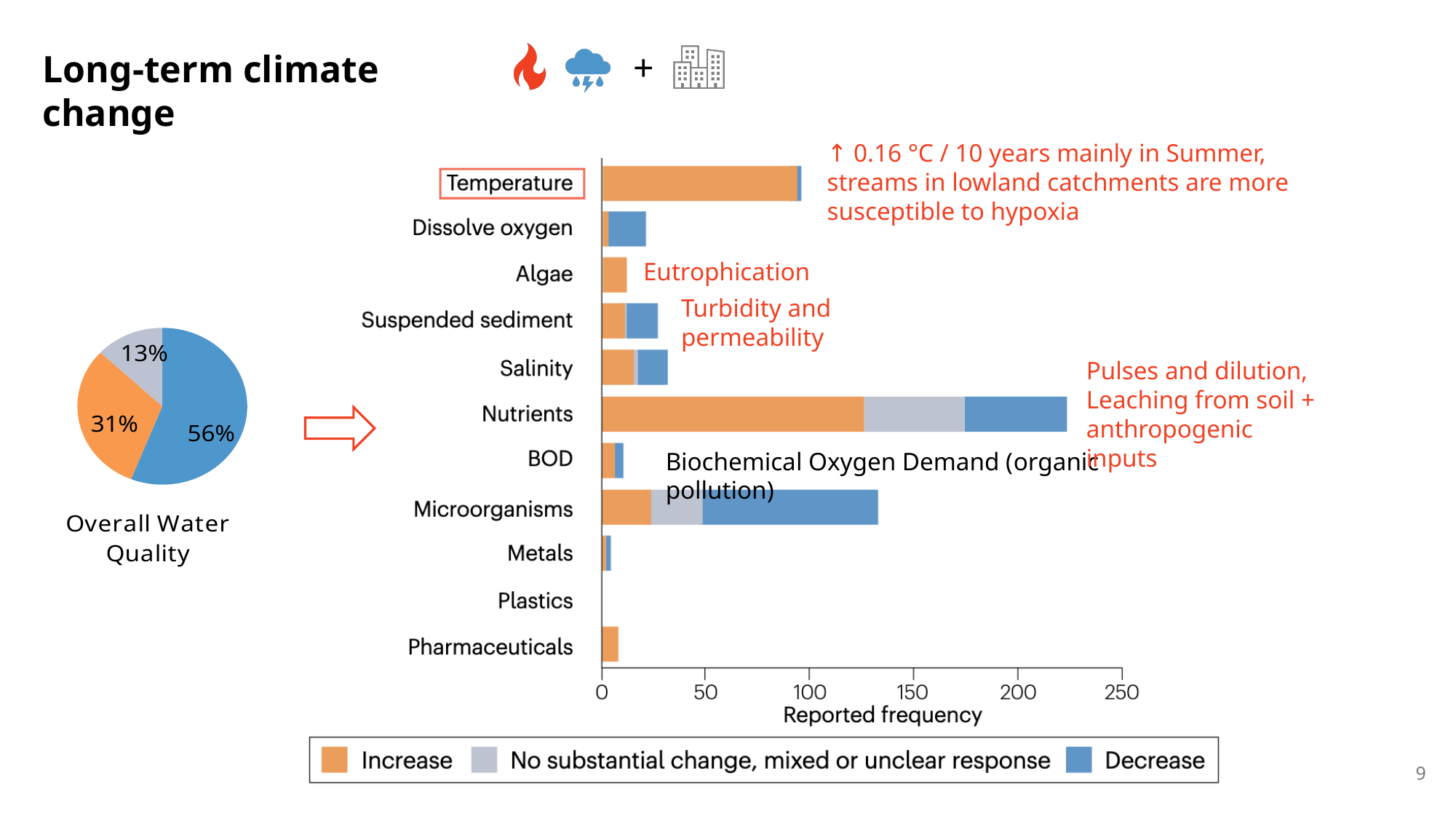
What is the x-axis label of the bar chart on the right? Reported frequency In the Overall Water Quality pie chart, what is the value of the largest slice? 56% How many categories are listed on the y axis of the Reported frequency bar chart? 11 In the Reported frequency bar chart, which category has no visible bar at all? Plastics In the Overall Water Quality pie chart, what is the value of the smallest slice? 13% In the Overall Water Quality pie chart, what is the difference between the largest and smallest slices? 43 percentage points In the Reported frequency bar chart, is the total bar for Nutrients greater or less than 200? greater In the Reported frequency bar chart, which has the longer total bar, Nutrients or Microorganisms? Nutrients In the Reported frequency bar chart, which category has the longest total bar? Nutrients How many series does the legend of the Reported frequency bar chart list? 3 What kind of chart is the Reported frequency chart on the right? Bar chart How many slices does the Overall Water Quality pie chart have? 3